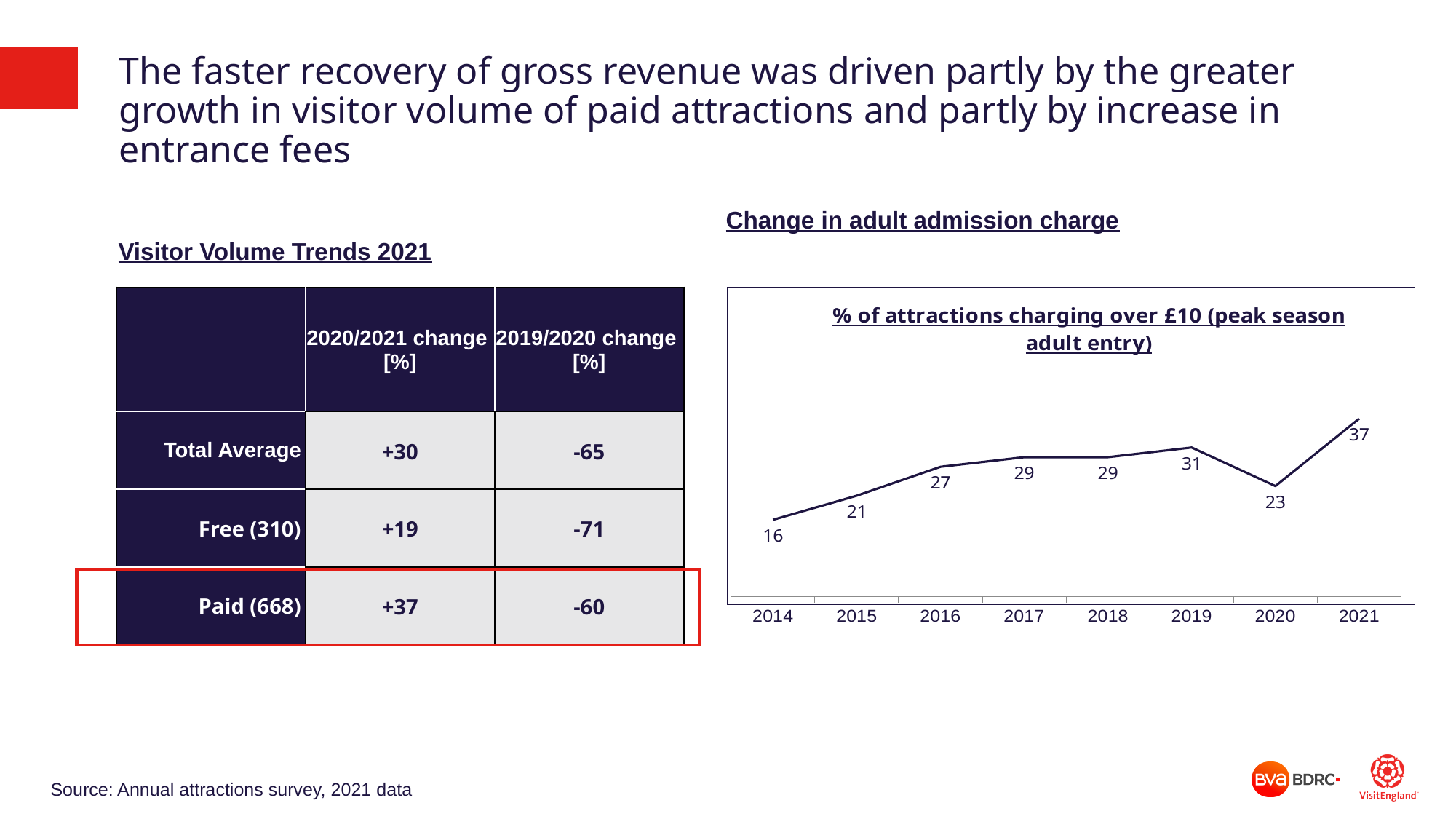
How many years are plotted in the chart of attractions charging over £10? 8 What is the title of the chart on the right of the slide? % of attractions charging over £10 (peak season adult entry) Which year has the highest percentage of attractions charging over £10? 2021 What percentage of attractions charged over £10 for peak season adult entry in 2014? 16 Did the percentage of attractions charging over £10 rise or fall between 2019 and 2020? Fall By how many points did the percentage of attractions charging over £10 change between 2020 and 2021? 14 Which year has a higher value in the chart, 2016 or 2020? 2016 What is the value shown for 2020 in the chart of attractions charging over £10? 23 What kind of chart is used to show the % of attractions charging over £10? Line chart What is the value shown for 2019 in the chart of attractions charging over £10? 31 Which year has the lowest percentage of attractions charging over £10? 2014 What is the difference between the 2014 and 2019 values in the chart of attractions charging over £10? 15